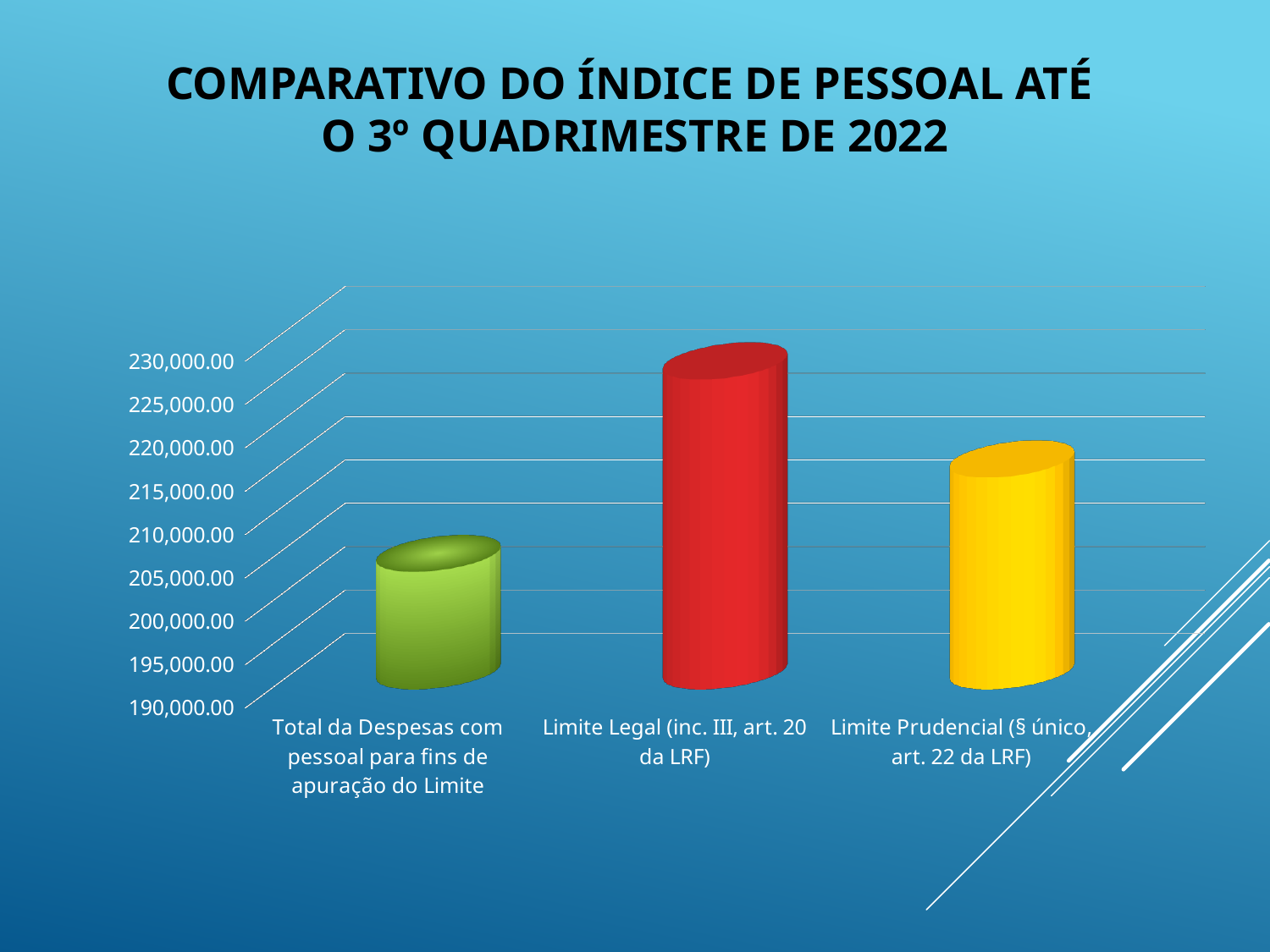
Which is larger: the value for Limite Prudencial (§ único, art. 22 da LRF) or the value for Total da Despesas com pessoal para fins de apuração do Limite? Limite Prudencial (§ único, art. 22 da LRF) Is the value for Limite Legal (inc. III, art. 20 da LRF) greater or less than 220,000.00? greater What kind of chart is shown on the slide? bar chart How many categories are plotted in the chart? 3 Is the value for Total da Despesas com pessoal para fins de apuração do Limite greater or less than 210,000.00? less What colour is the bar for Limite Legal (inc. III, art. 20 da LRF)? red Which category has the highest value? Limite Legal (inc. III, art. 20 da LRF) Is the value for Limite Prudencial (§ único, art. 22 da LRF) greater or less than 225,000.00? less Which is larger: the value for Limite Legal (inc. III, art. 20 da LRF) or the value for Limite Prudencial (§ único, art. 22 da LRF)? Limite Legal (inc. III, art. 20 da LRF) What is the title of the chart on the slide? COMPARATIVO DO ÍNDICE DE PESSOAL ATÉ O 3º QUADRIMESTRE DE 2022 Which category has the lowest value? Total da Despesas com pessoal para fins de apuração do Limite